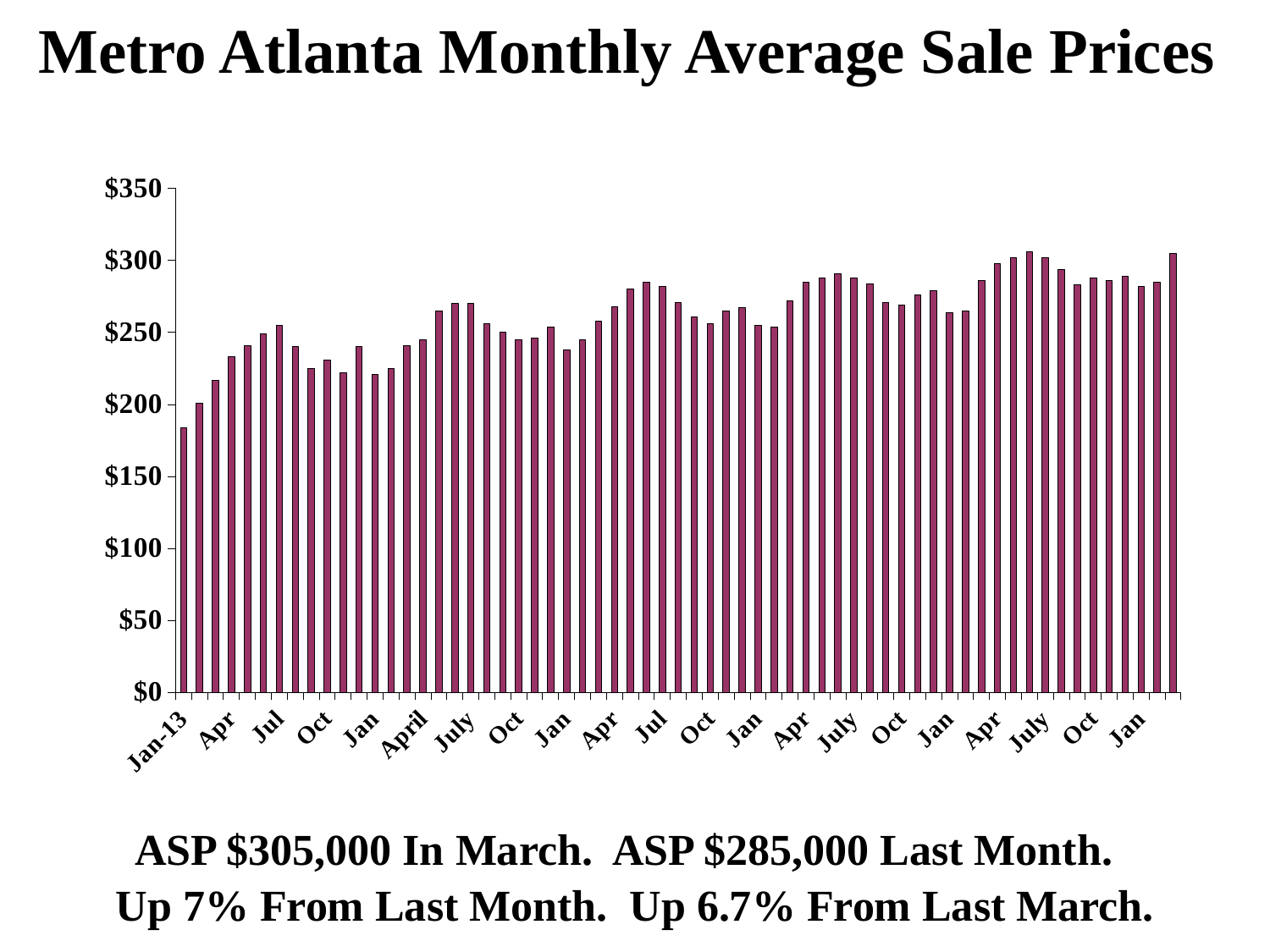
What is the highest value shown on the y-axis? $350 Is the value for the first Apr (2013) greater or less than $200? greater Which is larger, the value for Jan-13 or the value for the second Jul (2015)? Jul (2015) What is the title of the chart? Metro Atlanta Monthly Average Sale Prices Do the average sale prices generally rise or fall from Jan-13 to the end of the chart? rise Is the value for the last Jan (2018) greater or less than $300? less Which month has the lowest average sale price in the chart? Jan-13 Is the value for Jan-13 greater or less than $200? less What kind of chart is shown on the slide? bar chart